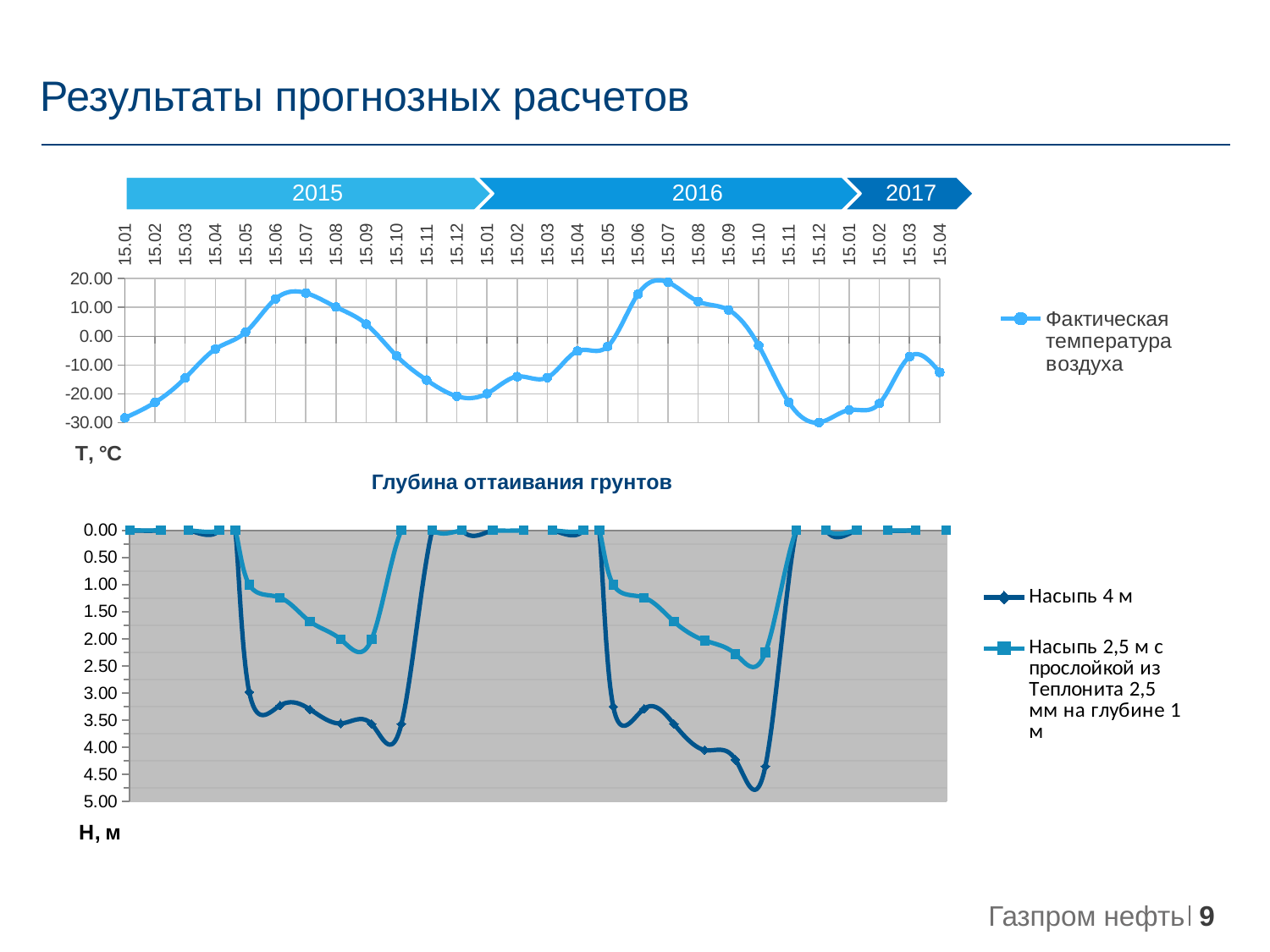
In the bottom chart (Глубина оттаивания грунтов), at which date does Насыпь 4 м reach its greatest thaw depth? 15.10 2016 In the top chart (Фактическая температура воздуха), is the value for 15.01 2015 greater or less than -20.00? less In the top chart (Фактическая температура воздуха), is the value for 15.07 2015 greater or less than 10.00? greater In the top chart (Фактическая температура воздуха), at which date does the temperature reach its highest value? 15.07 2016 In the top chart (Фактическая температура воздуха), how many data points are plotted along the x axis? 28 What kind of chart is the top chart showing Фактическая температура воздуха? line chart In the bottom chart (Глубина оттаивания грунтов), is the value for Насыпь 4 м at 15.10 2016 greater or less than 4.00? greater What is the title of the bottom chart? Глубина оттаивания грунтов In the top chart, does the temperature rise or fall from 15.01 2015 to 15.07 2015? rise How many series does the legend of the bottom chart (Глубина оттаивания грунтов) list? 2 In the bottom chart (Глубина оттаивания грунтов), which series has the greater thaw depth at 15.10 2016? Насыпь 4 м